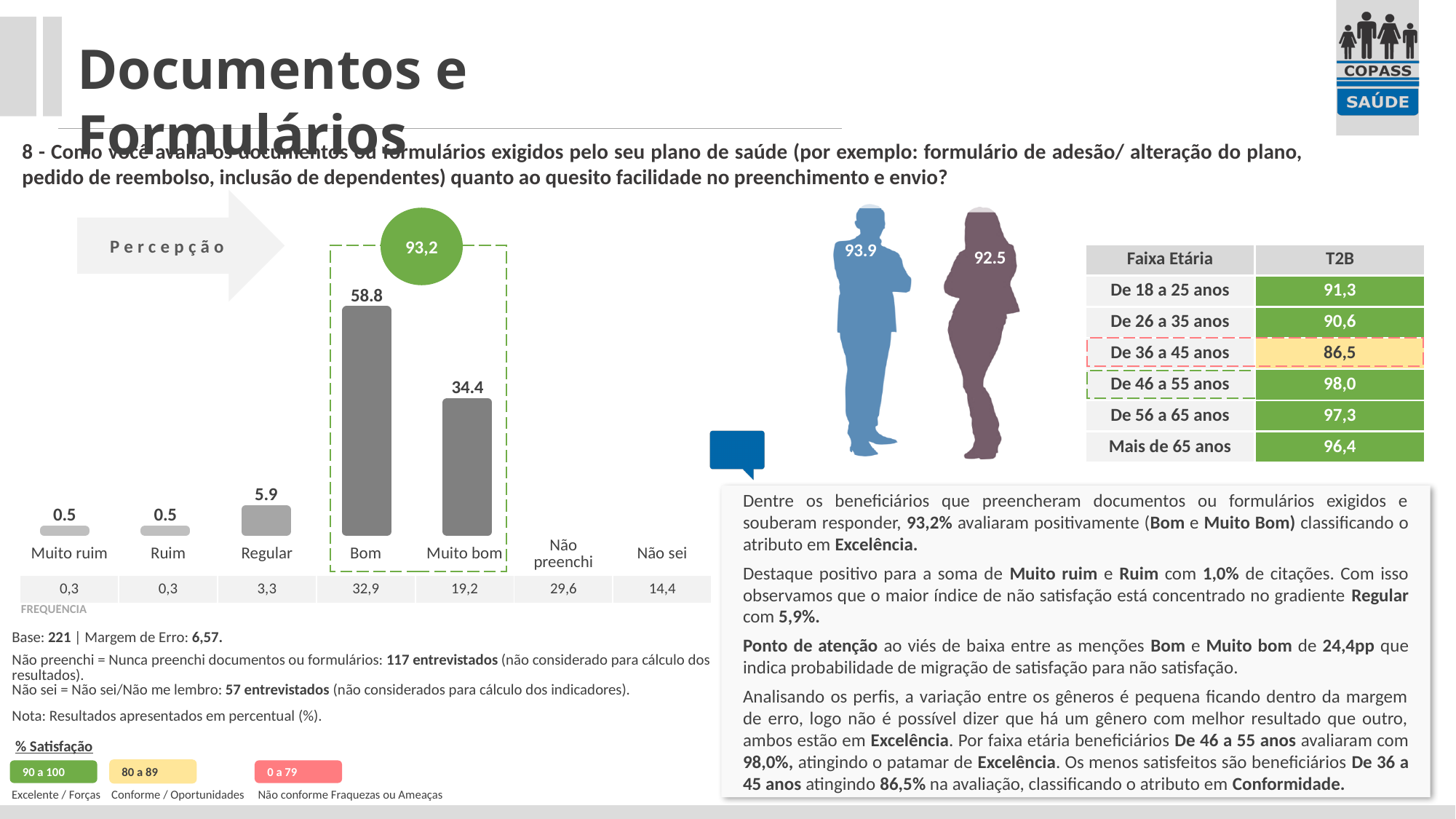
What is the value shown for the Muito bom bar in the bar chart? 34.4 In the Faixa Etária table, which age group has the lowest T2B value? De 36 a 45 anos Which category has the highest bar in the bar chart? Bom In the FREQUENCIA row below the bar chart, what is the value for Não preenchi? 29,6 What is the value shown for the Bom bar in the bar chart? 58.8 In the Faixa Etária table, what is the T2B value for De 46 a 55 anos? 98,0 What value is shown in the green circle above the Bom and Muito bom bars? 93,2 How many age groups are listed in the Faixa Etária table? 6 Which is larger in the bar chart, Regular or Muito bom? Muito bom What is the difference between the Bom and Muito bom values in the bar chart? 24.4 What is the value shown for the Regular bar in the bar chart? 5.9 What kind of chart is used to show the Muito ruim to Muito bom values? bar chart